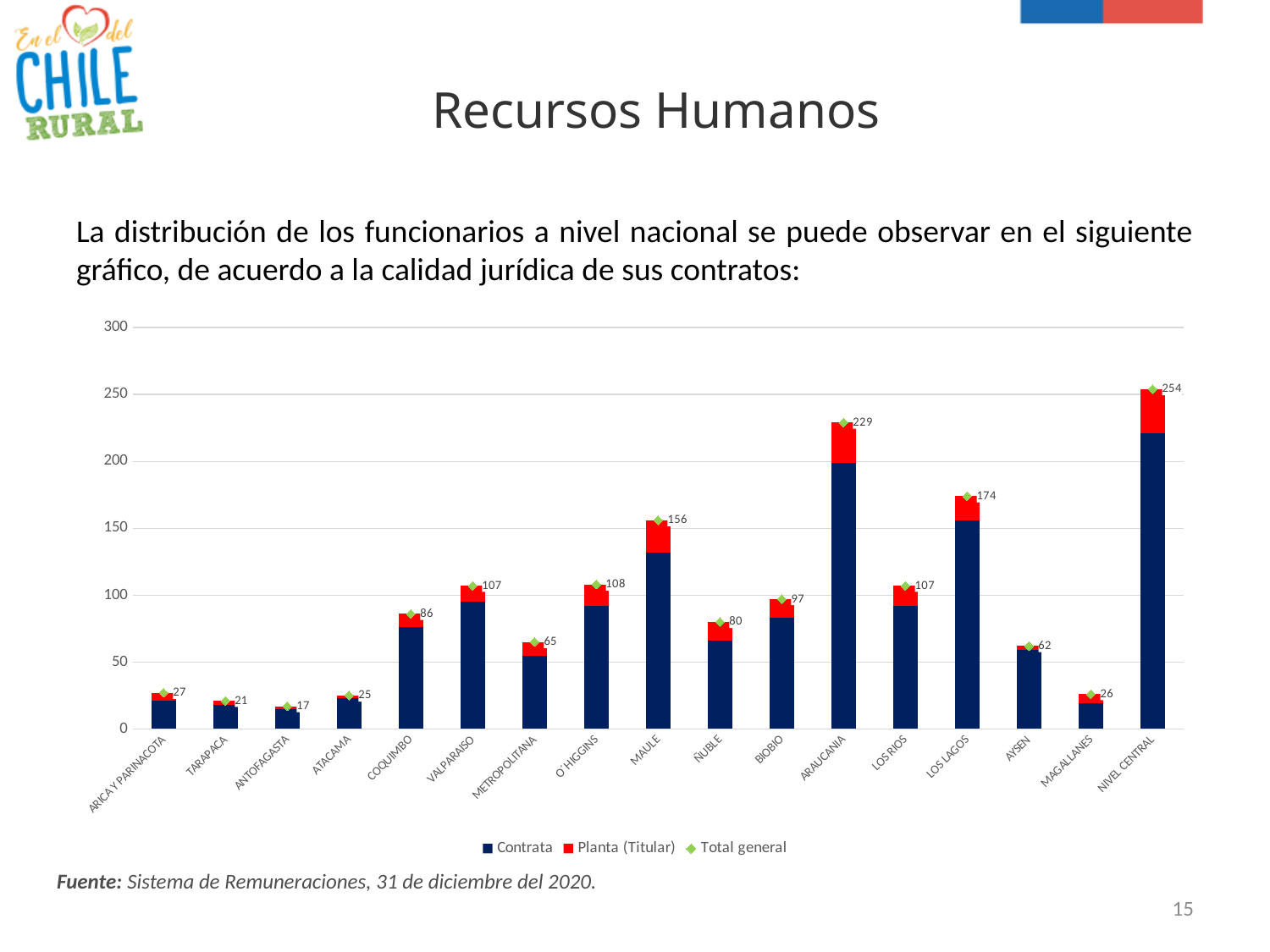
How many categories are shown on the x axis of the chart? 17 What is the difference between the Total general values for NIVEL CENTRAL and ARAUCANIA? 25 What is the Total general value shown for METROPOLITANA? 65 Which colour represents the Planta (Titular) series in the chart? Red Which category has the highest Total general value? NIVEL CENTRAL Which has a larger Total general value, LOS LAGOS or MAULE? LOS LAGOS How many series does the chart legend list? 3 What kind of chart is shown on the slide? Stacked bar chart What is the Total general value shown for ARAUCANIA? 229 Which category has the lowest Total general value? ANTOFAGASTA What is the Total general value shown for MAULE? 156 Is the Contrata value for ARAUCANIA greater or less than 150? greater